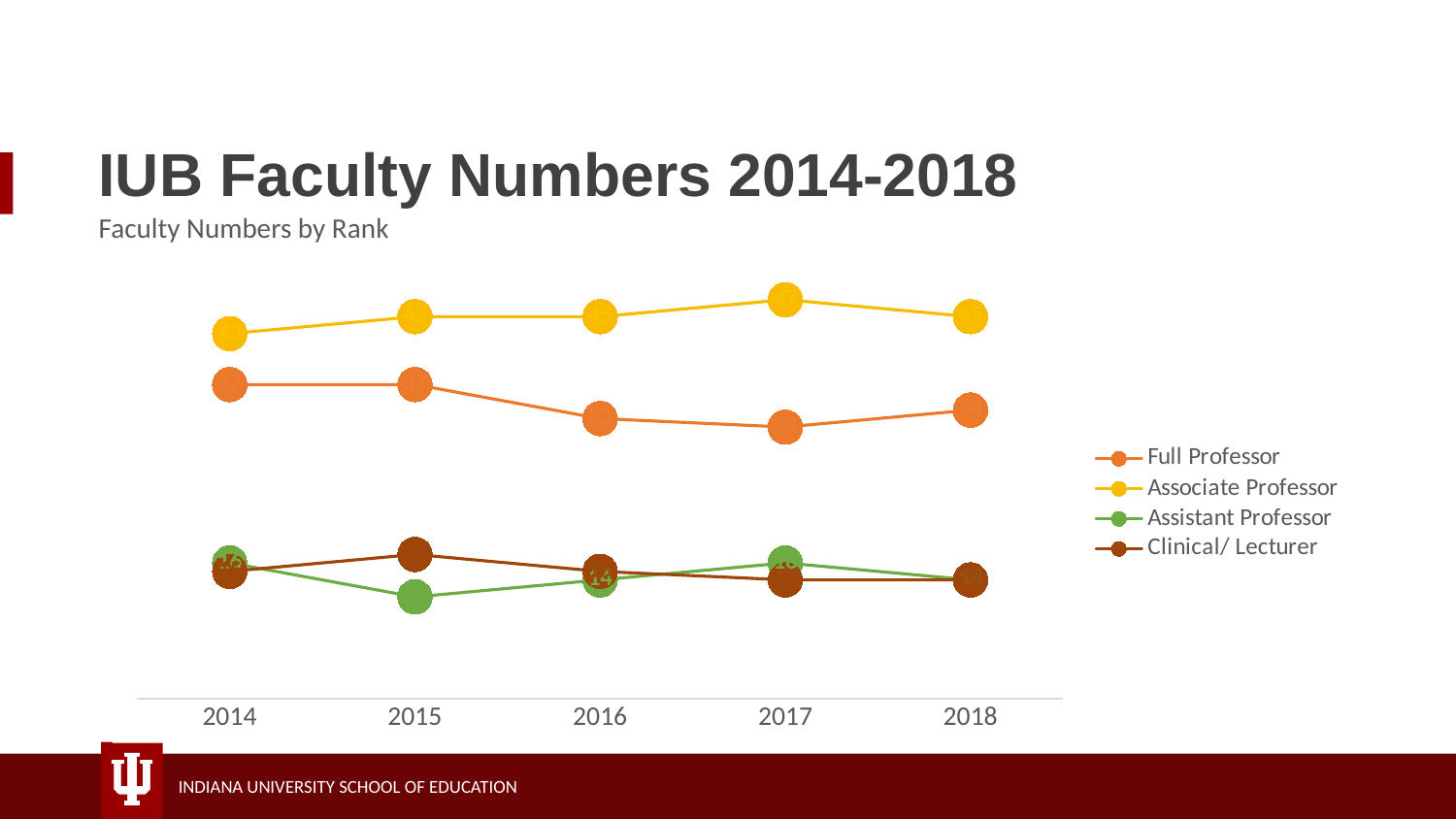
What kind of chart is shown on the slide? line chart In 2018, which is larger: Full Professor or Associate Professor? Associate Professor How many years are plotted along the x axis? 5 In 2015, which is larger: Assistant Professor or Clinical/ Lecturer? Clinical/ Lecturer In which year does the Associate Professor line reach its highest point? 2017 Which rank has the highest faculty numbers across all years shown? Associate Professor In which year does the Clinical/ Lecturer line reach its highest point? 2015 In which year does the Assistant Professor line reach its lowest point? 2015 How many series does the legend list? 4 What is the subtitle shown above the chart? Faculty Numbers by Rank In which year does the Full Professor line reach its lowest point? 2017 Does the Associate Professor line rise or fall from 2014 to 2017? rise